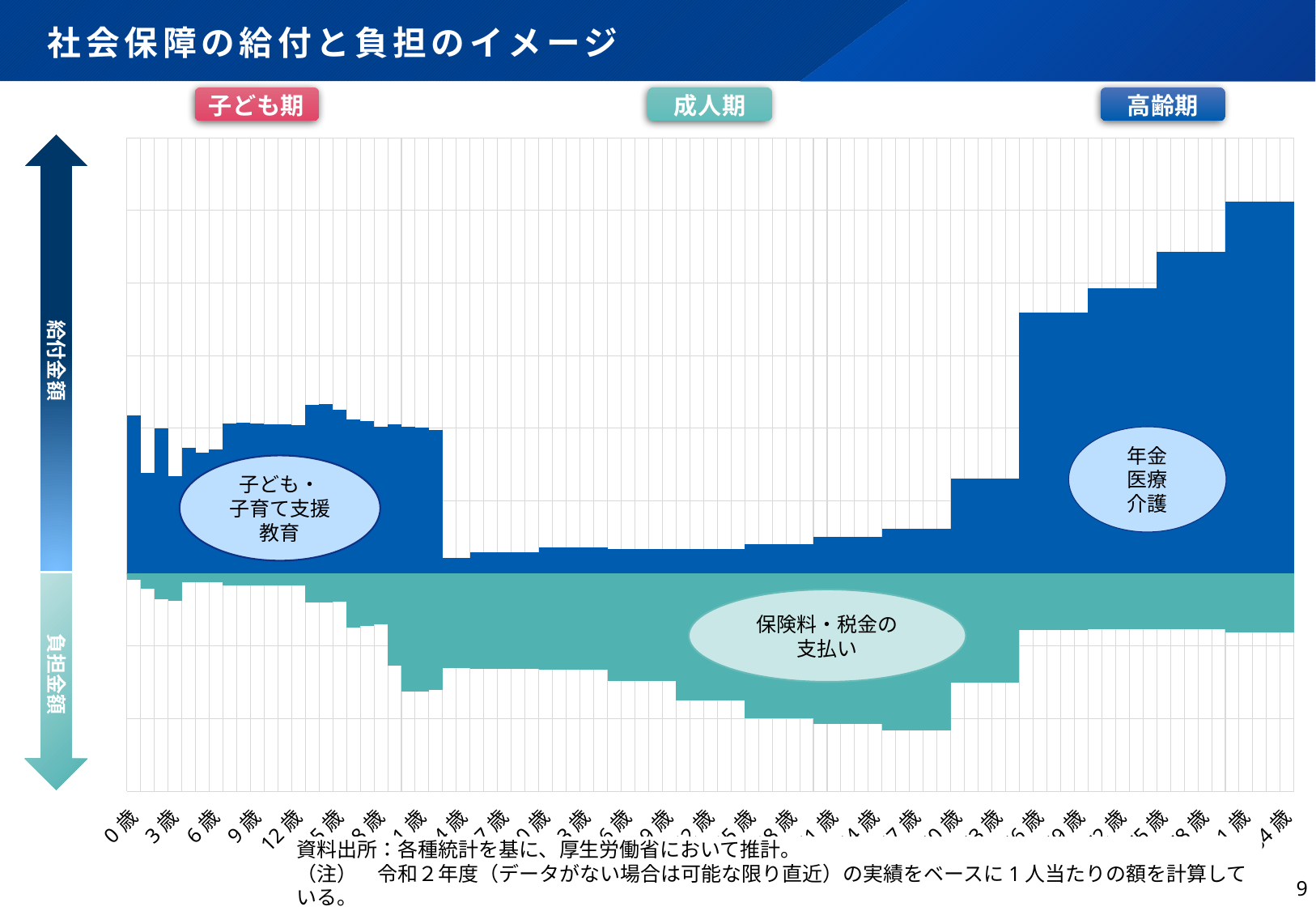
How many series does the chart plot (as labelled on the vertical axis)? 2 What kind of chart is shown on the slide? bar chart What are the two series plotted on the chart? 給付金額 and 負担金額 How many life stages are labelled above the chart? 3 How does the 給付金額 change across the 高齢期 bars moving from left to right? It rises Is the 給付金額 in 成人期 larger or smaller than in 子ども期? Smaller Which colour represents 給付金額 on the chart? Blue In which life stage is the 給付金額 (benefit amount) highest? 高齢期 Is the 給付金額 larger at 0歳 or in the 高齢期 bars at the right end of the chart? 高齢期 In which life stage is the 負担金額 (burden amount) highest? 成人期 Is the 負担金額 larger in 子ども期 or in 成人期? 成人期 How does the 給付金額 change from 子ども期 into the early 成人期 bars? It falls